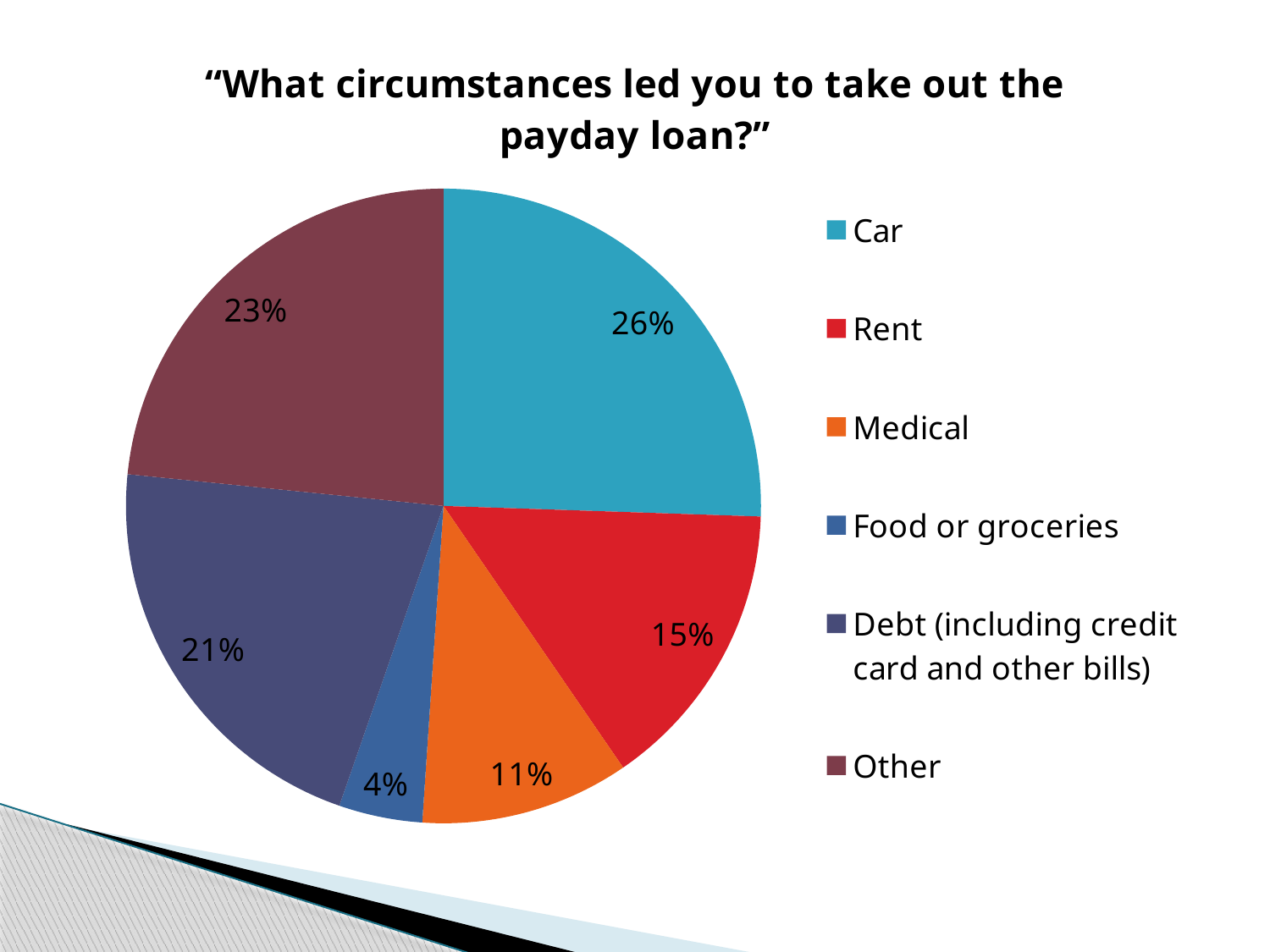
What percentage is shown for Debt (including credit card and other bills)? 21% How many categories does the pie chart show? 6 What percentage is shown for Medical? 11% Which category has the largest slice of the pie? Car What percentage is shown for Rent? 15% What is the title of the chart? "What circumstances led you to take out the payday loan?" What kind of chart is shown on the slide? Pie chart What share of the pie is labelled for Car? 26% Which is larger, the share for Other or the share for Debt (including credit card and other bills)? Other What is the difference in percentage points between Car and Rent? 11 Which category has the smallest slice of the pie? Food or groceries What percentage is shown for Food or groceries? 4%